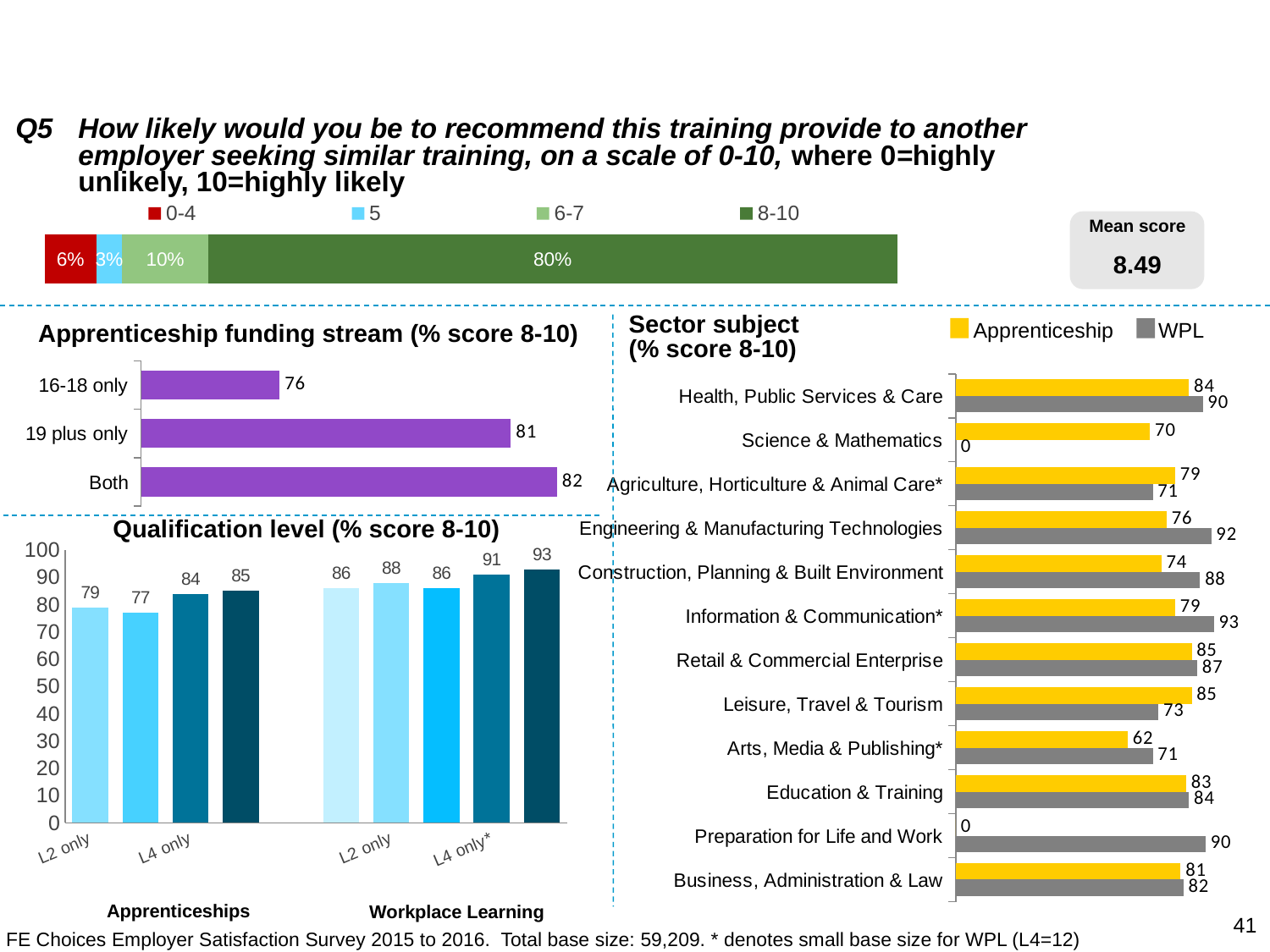
In the Sector subject chart, what is the difference between the WPL and Apprenticeship values for Engineering & Manufacturing Technologies? 16 In the Apprenticeship funding stream chart, which category has the lowest value? 16-18 only In the Qualification level chart, what is the value for 'L2 only' under Apprenticeships? 79 In the Sector subject chart, what is the Apprenticeship value for Arts, Media & Publishing*? 62 In the top stacked bar chart, what percentage gave a score of 0-4? 6% In the top stacked bar chart, what percentage of employers gave a score of 8-10? 80% In the Apprenticeship funding stream chart, what is the value for '19 plus only'? 81 In the Sector subject chart, what is the WPL value for Information & Communication*? 93 In the Qualification level chart, what is the value for 'L4 only*' under Workplace Learning? 91 How many series does the legend of the Sector subject chart list? 2 In the Sector subject chart, which is larger for Leisure, Travel & Tourism: Apprenticeship or WPL? Apprenticeship In the Apprenticeship funding stream chart, what is the difference between 'Both' and '16-18 only'? 6